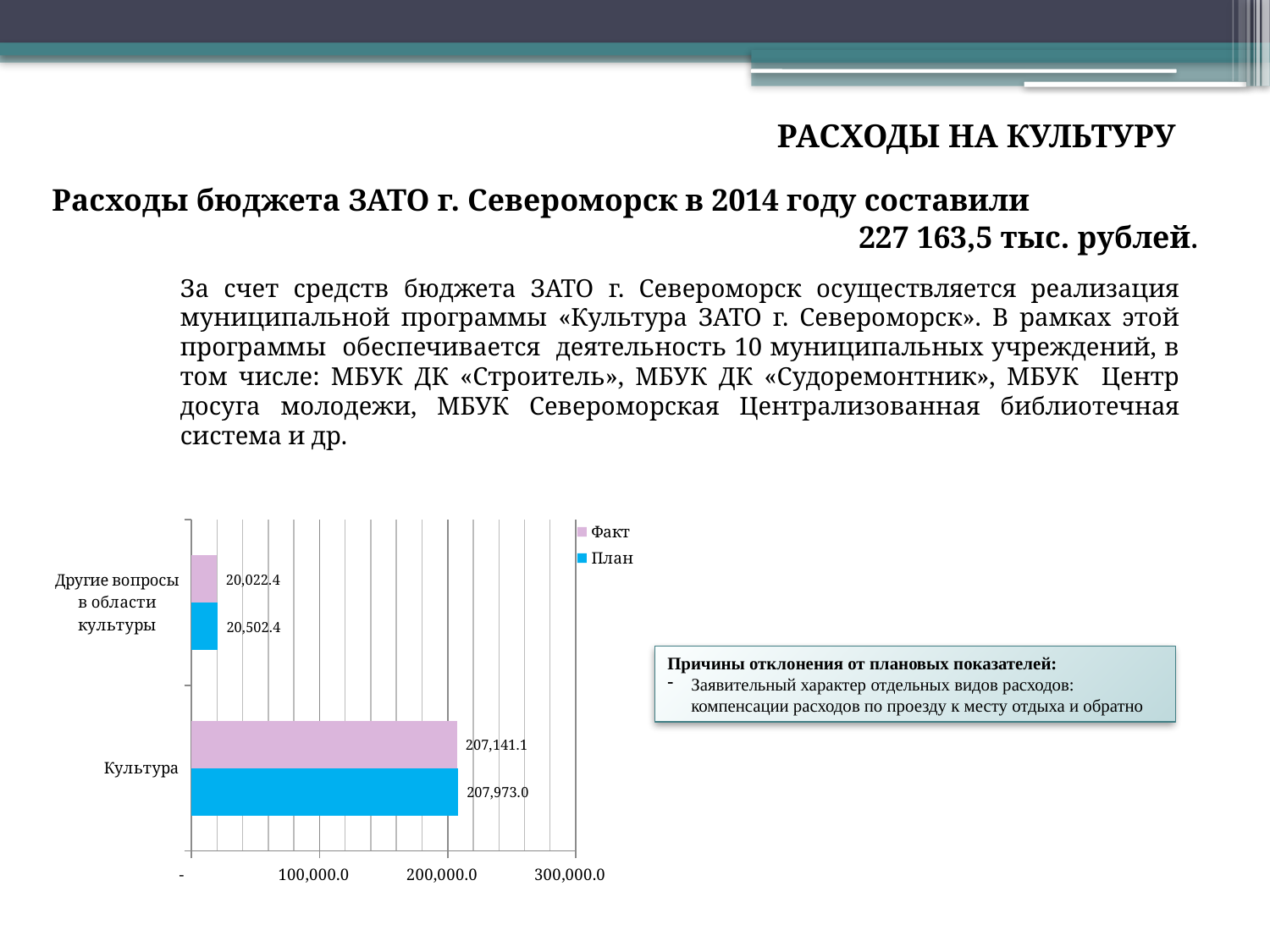
What is the difference between the План and Факт values for Культура? 831.9 What is the Факт value for Культура? 207,141.1 What is the План value for Другие вопросы в области культуры? 20,502.4 Is the Факт value for Культура greater or less than 200,000.0? greater What is the План value for Культура? 207,973.0 Which category has the lowest Факт value? Другие вопросы в области культуры What is the Факт value for Другие вопросы в области культуры? 20,022.4 What kind of chart is shown on the slide? bar chart How many categories are shown on the chart? 2 How many series does the legend list? 2 What is the difference between the План and Факт values for Другие вопросы в области культуры? 480.0 Which category has the highest План value? Культура